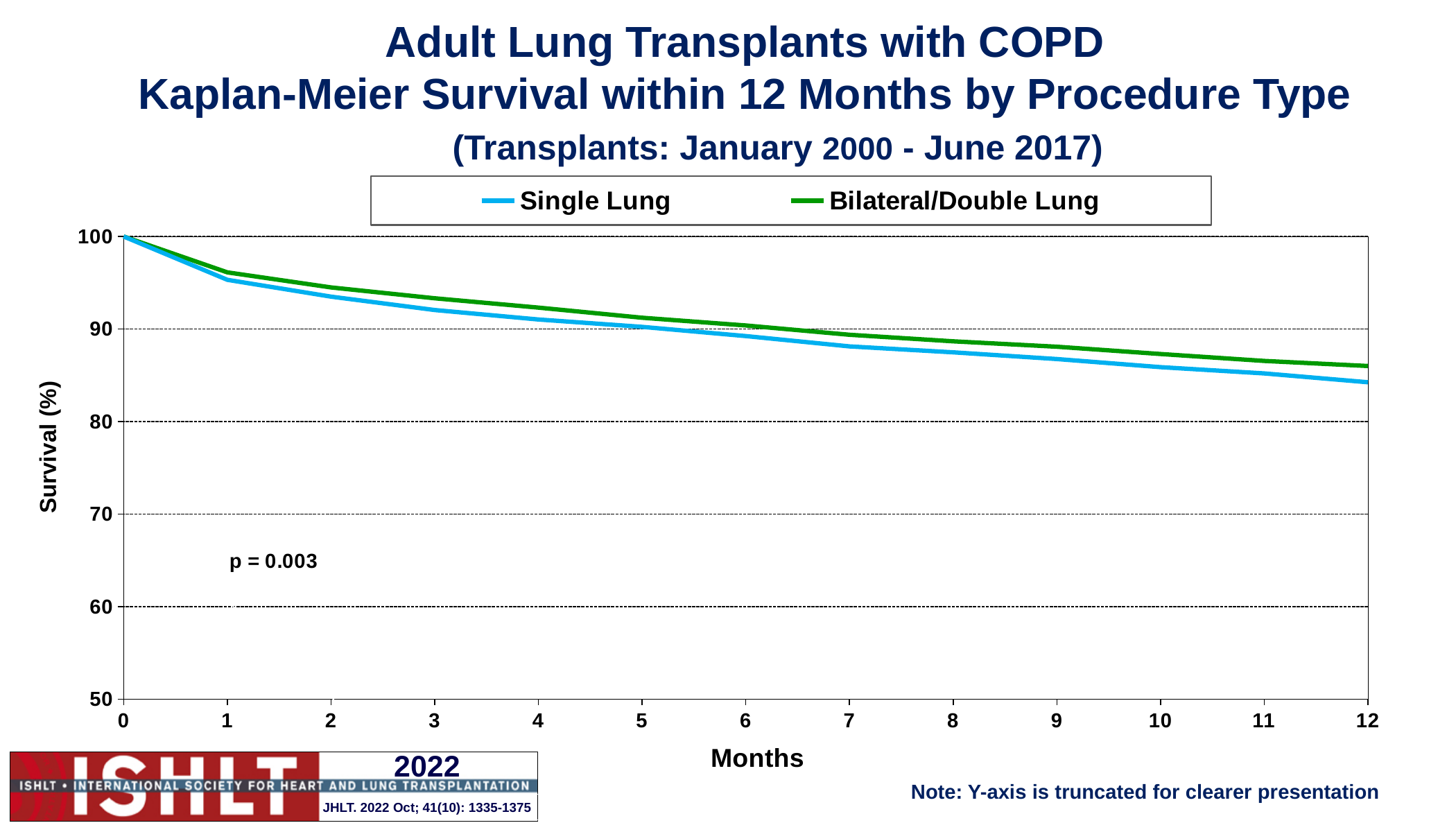
Which series is drawn in green? Bilateral/Double Lung How many series does the legend list? 2 What kind of chart is shown on the slide? line chart Is the survival value for Single Lung at month 12 greater or less than 90? less What p-value is printed on the chart? p = 0.003 At month 12, which series has the higher survival, Single Lung or Bilateral/Double Lung? Bilateral/Double Lung Is the survival value for Single Lung at month 3 greater or less than 90? greater What is the survival value for Single Lung at month 0? 100 Is the survival value for Bilateral/Double Lung at month 1 greater or less than 90? greater Do the survival values for Bilateral/Double Lung rise or fall as months increase? fall